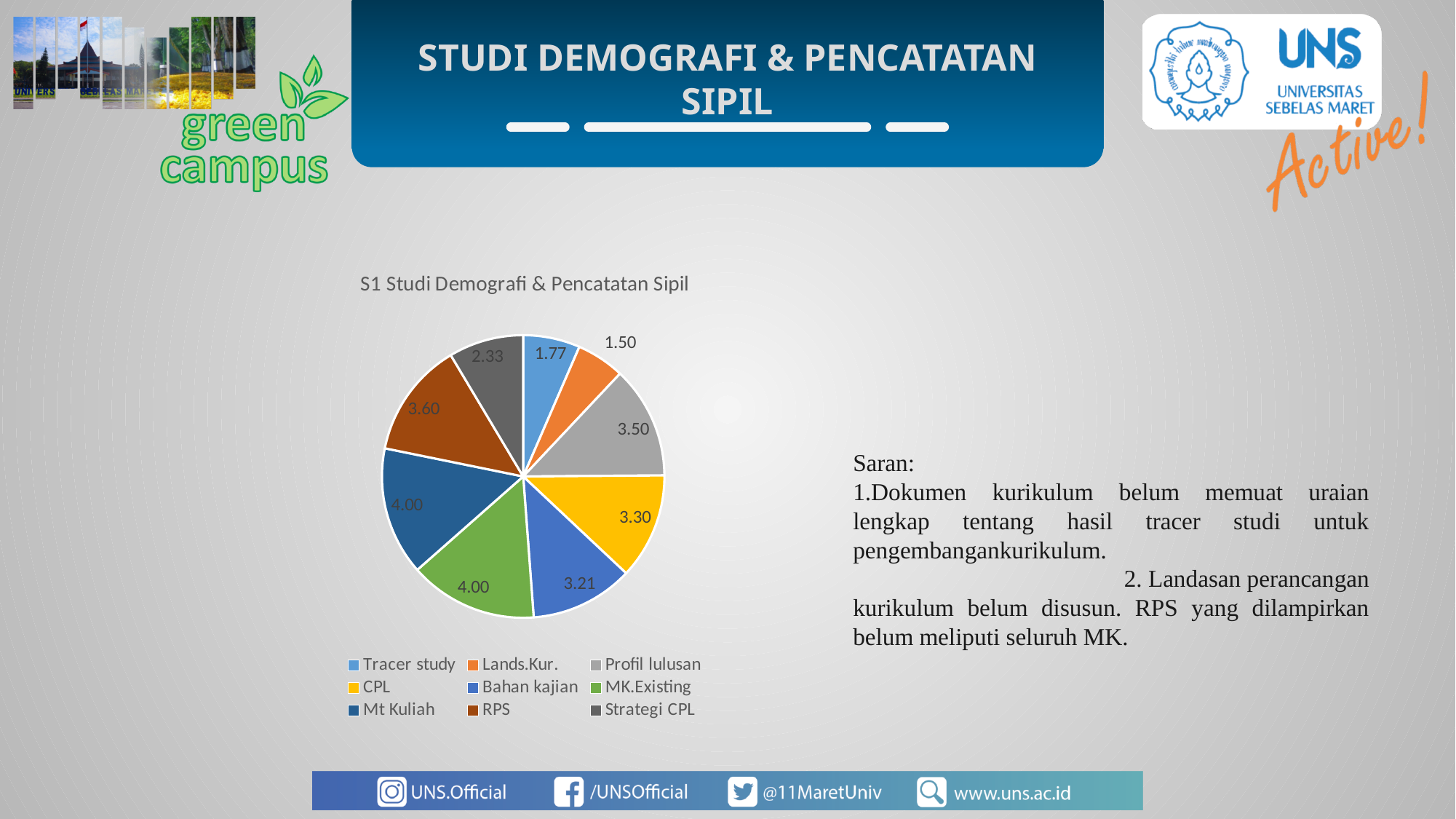
What is the value for Strategi CPL? 2.33 Which category has the lowest value? Lands.Kur. How many categories does the pie chart have? 9 What is the title of the chart? S1 Studi Demografi & Pencatatan Sipil How many entries does the legend list? 9 What type of chart is shown on the slide? Pie chart Which is larger, the value for RPS or the value for Profil lulusan? RPS What is the value for RPS? 3.60 What is the value for Tracer study? 1.77 What is the value for Profil lulusan? 3.50 What is the difference between the values for Mt Kuliah and Strategi CPL? 1.67 What is the difference between the values for CPL and Bahan kajian? 0.09